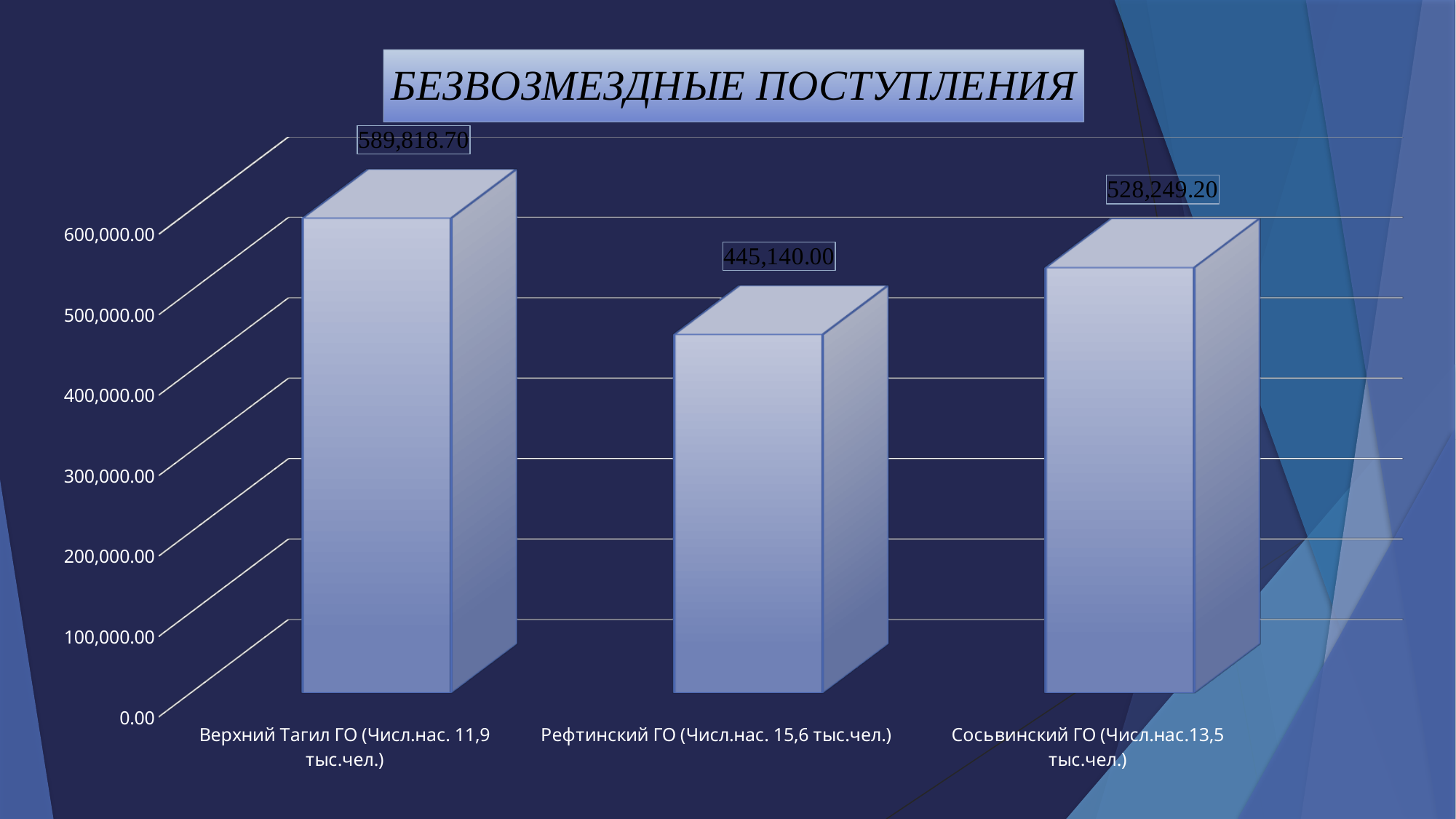
What is the difference between the values for Сосьвинский ГО and Рефтинский ГО? 83,109.20 Which category has the highest value? Верхний Тагил ГО Which is larger, the value for Сосьвинский ГО or the value for Рефтинский ГО? Сосьвинский ГО Is the value for Рефтинский ГО greater or less than 500,000.00? less What is the value for Сосьвинский ГО? 528,249.20 What is the value for Рефтинский ГО? 445,140.00 Which category has the lowest value? Рефтинский ГО What is the title of the chart? БЕЗВОЗМЕЗДНЫЕ ПОСТУПЛЕНИЯ How many categories are shown in the chart? 3 What kind of chart is shown on the slide? bar chart What is the value for Верхний Тагил ГО? 589,818.70 What is the difference between the values for Верхний Тагил ГО and Сосьвинский ГО? 61,569.50